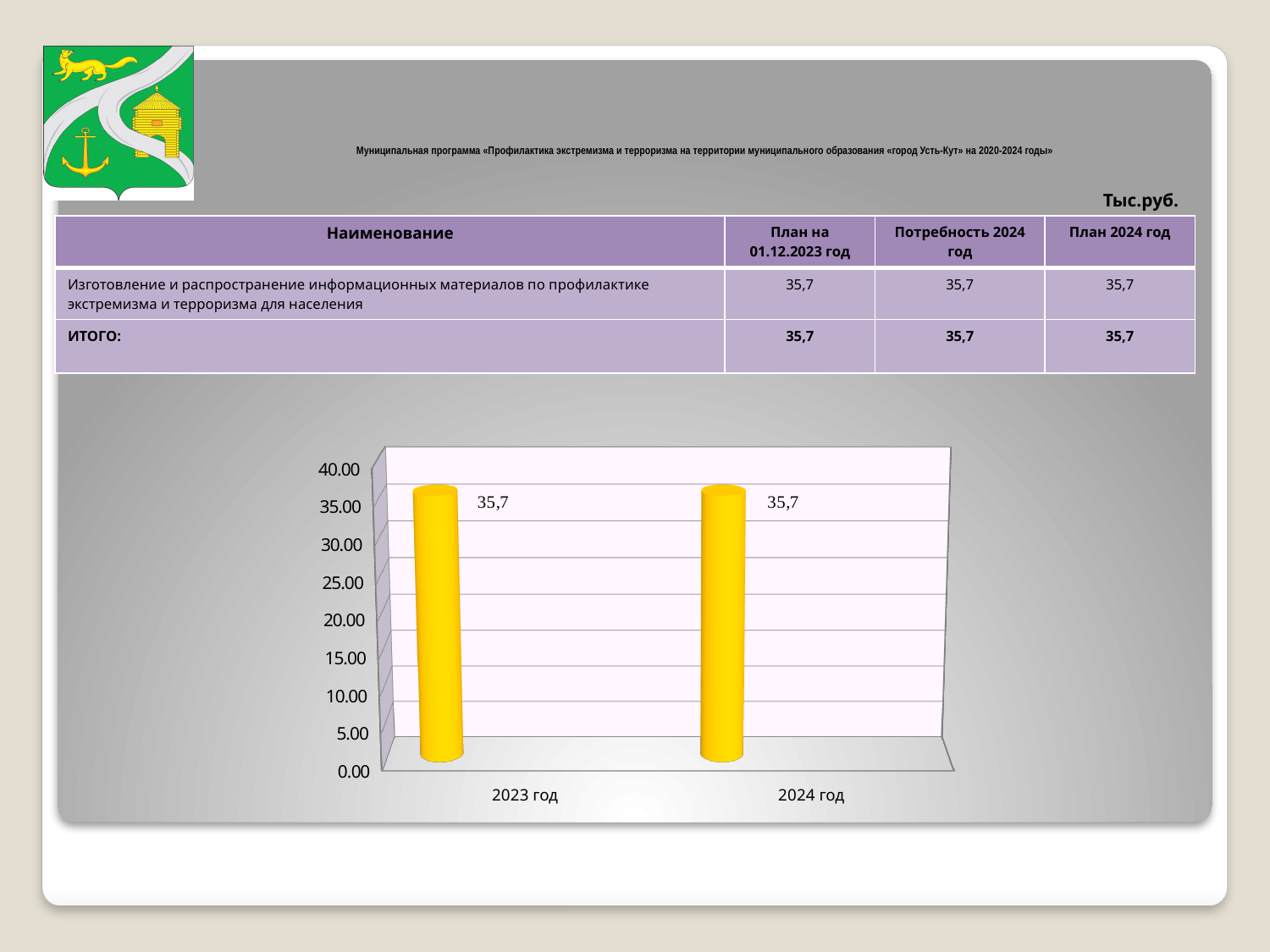
Is the value for 2024 год greater or less than 40.00? less What is the difference between the values for 2023 год and 2024 год? 0 Is the value for 2023 год greater or less than 30.00? greater What kind of chart is shown on the slide? bar chart Do the values rise, fall or stay the same from 2023 год to 2024 год? stay the same What is the highest tick value shown on the vertical axis of the chart? 40.00 What colour are the bars in the chart? yellow What is the value for 2024 год in the chart? 35,7 How many categories are shown on the x axis of the chart? 2 What is the value for 2023 год in the chart? 35,7